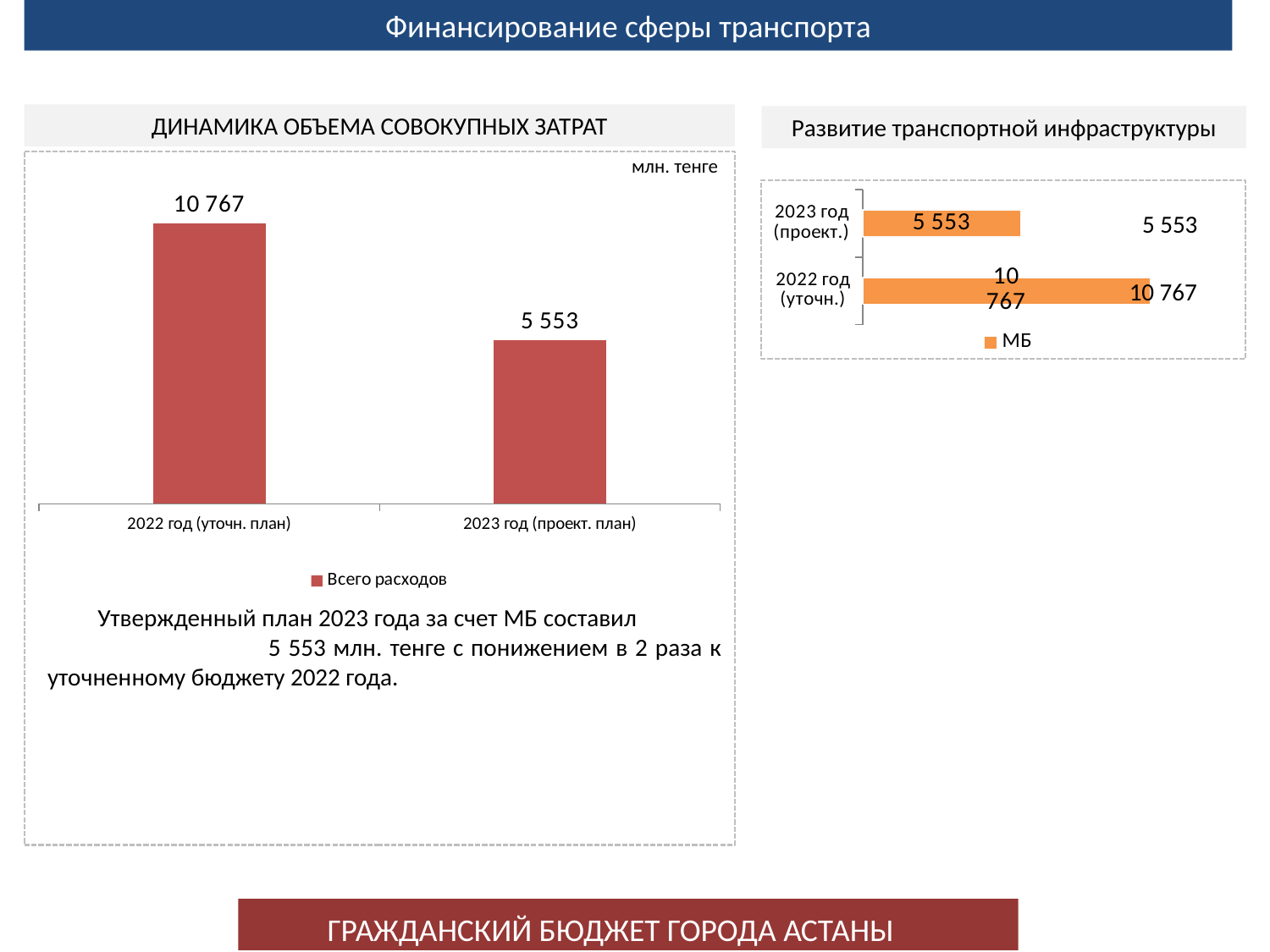
In the chart 'ДИНАМИКА ОБЪЕМА СОВОКУПНЫХ ЗАТРАТ', how many categories are shown on the x axis? 2 In the chart 'ДИНАМИКА ОБЪЕМА СОВОКУПНЫХ ЗАТРАТ', do the values rise or fall from 2022 to 2023? fall What type of chart is 'ДИНАМИКА ОБЪЕМА СОВОКУПНЫХ ЗАТРАТ'? bar chart In the chart 'ДИНАМИКА ОБЪЕМА СОВОКУПНЫХ ЗАТРАТ', what is the value for 2023 год (проект. план)? 5 553 In the chart 'Развитие транспортной инфраструктуры', how many series does the legend list? 1 In the chart 'Развитие транспортной инфраструктуры', what is the value for 2023 год (проект.)? 5 553 In the chart 'ДИНАМИКА ОБЪЕМА СОВОКУПНЫХ ЗАТРАТ', what series name does the legend show? Всего расходов In the chart 'ДИНАМИКА ОБЪЕМА СОВОКУПНЫХ ЗАТРАТ', which category has the highest value? 2022 год (уточн. план) In the chart 'Развитие транспортной инфраструктуры', what is the value for 2022 год (уточн.)? 10 767 In the chart 'Развитие транспортной инфраструктуры', which category has the lowest value? 2023 год (проект.) In the chart 'ДИНАМИКА ОБЪЕМА СОВОКУПНЫХ ЗАТРАТ', what is the value for 2022 год (уточн. план)? 10 767 In the chart 'ДИНАМИКА ОБЪЕМА СОВОКУПНЫХ ЗАТРАТ', what is the difference between the 2022 and 2023 values? 5 214